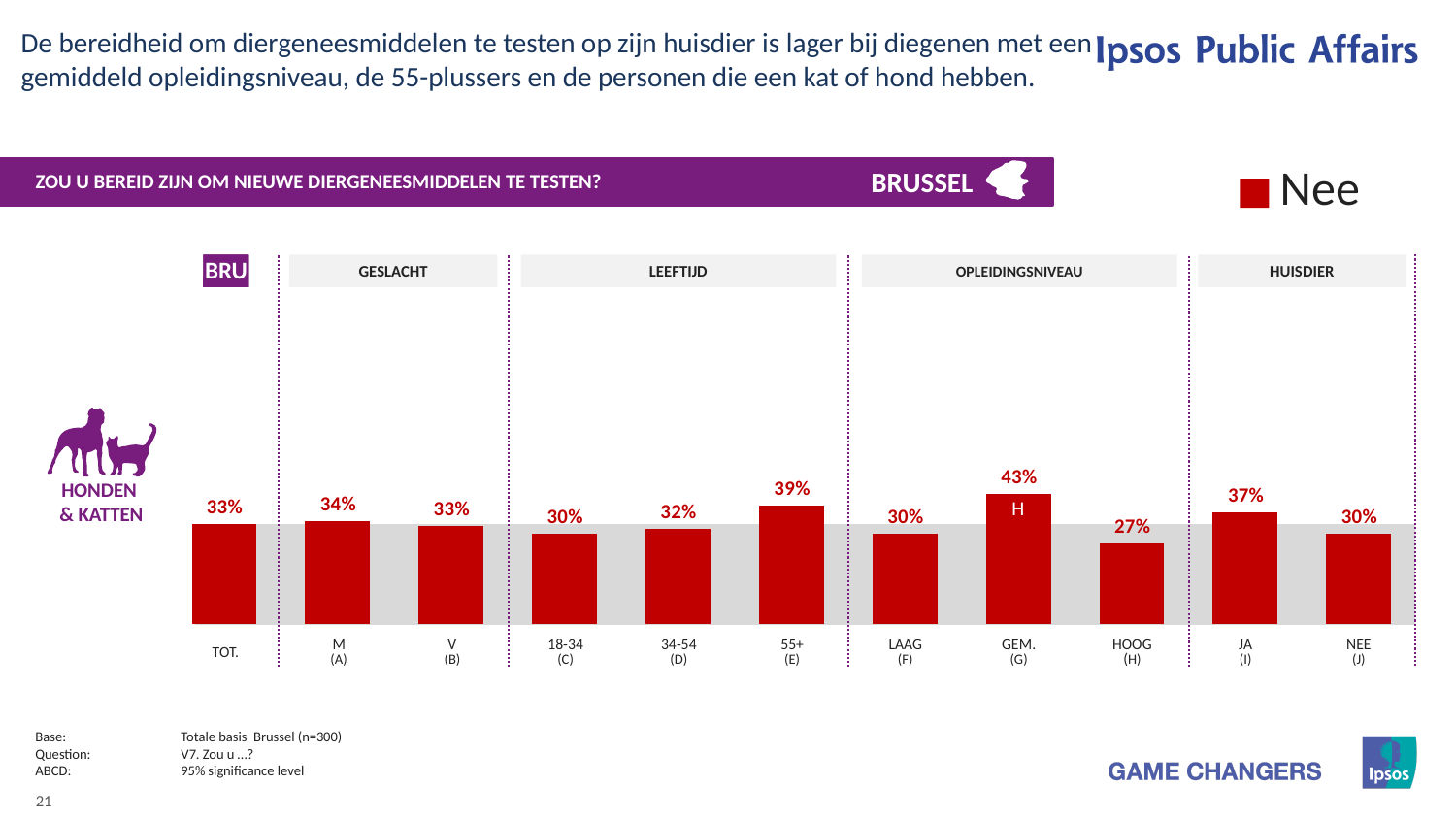
What is the difference between the values for GEM. and HOOG? 16% What kind of chart is shown on the slide? Bar chart What is the value for TOT. in the chart? 33% How many bars are plotted in the chart? 11 What is the value for HOOG? 27% Which category has the highest value in the chart? GEM. Which category has the lowest value in the chart? HOOG Which is larger, the value for 18-34 or the value for 55+? 55+ How many series does the legend list? 1 What is the difference between the values for JA and NEE under HUISDIER? 7% What is the value for the 55+ age group? 39% What is the value for GEM. under OPLEIDINGSNIVEAU? 43%